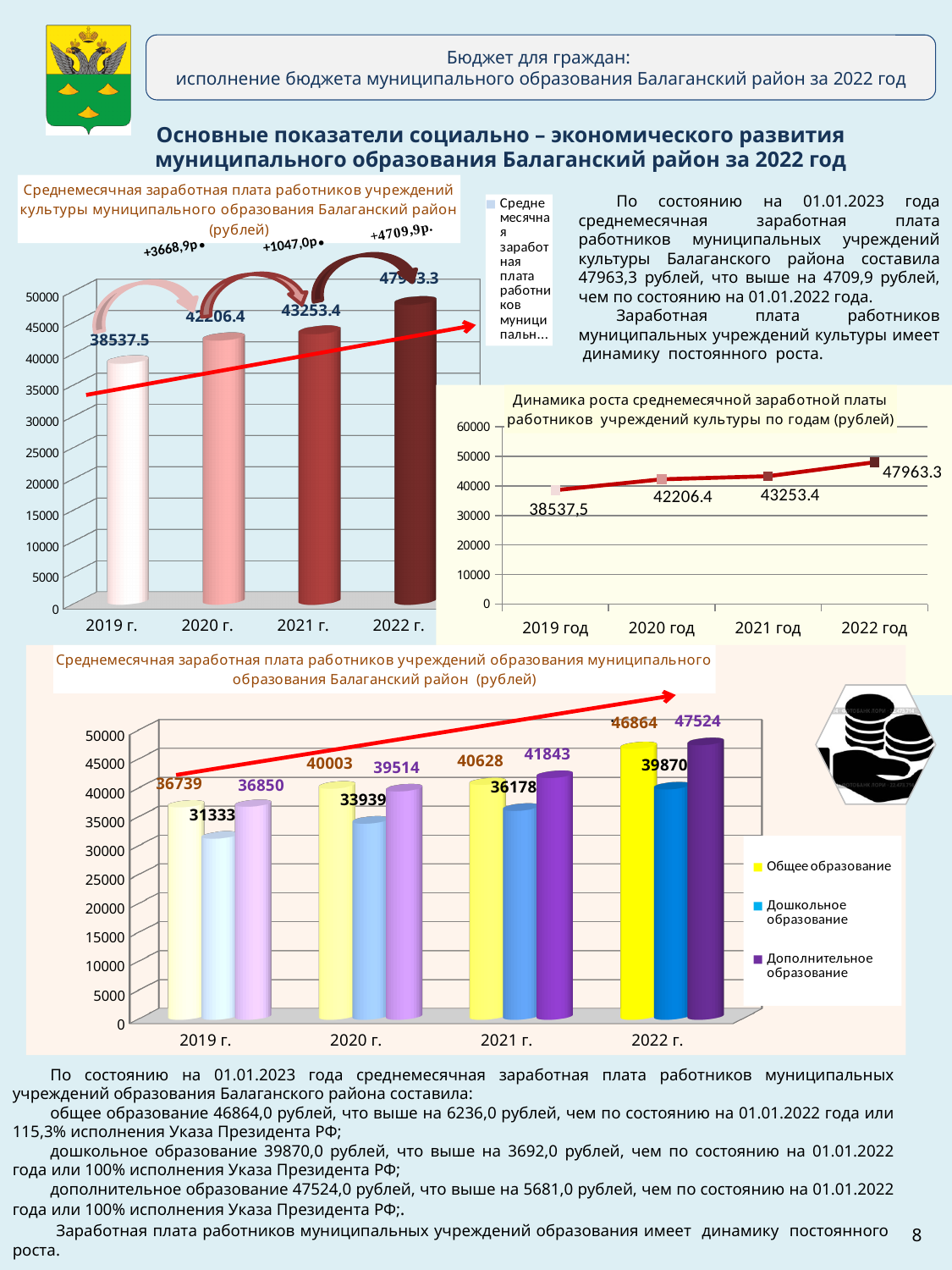
In the bottom bar chart 'Среднемесячная заработная плата работников учреждений образования', what is the difference between Дополнительное образование and Дошкольное образование in 2021 г.? 5665 In the top-left bar chart 'Среднемесячная заработная плата работников учреждений культуры', what is the value for 2020 г.? 42206.4 In the line chart 'Динамика роста среднемесячной заработной платы работников учреждений культуры по годам (рублей)', what is the value for 2019 год? 38537,5 In the bottom bar chart 'Среднемесячная заработная плата работников учреждений образования', what is the value for Общее образование in 2020 г.? 40003 What kind of chart is the chart titled 'Динамика роста среднемесячной заработной платы работников учреждений культуры по годам (рублей)'? line chart In the bottom bar chart 'Среднемесячная заработная плата работников учреждений образования', which series has the highest value in 2022 г.? Дополнительное образование In the top-left bar chart 'Среднемесячная заработная плата работников учреждений культуры', how many years are shown on the x axis? 4 In the bottom bar chart 'Среднемесячная заработная плата работников учреждений образования', what is the value for Дошкольное образование in 2022 г.? 39870 In the line chart 'Динамика роста среднемесячной заработной платы работников учреждений культуры по годам (рублей)', do the values rise or fall from 2019 год to 2022 год? rise In the top-left bar chart 'Среднемесячная заработная плата работников учреждений культуры', which year has the lowest value? 2019 г. In the bottom bar chart 'Среднемесячная заработная плата работников учреждений образования', how many series does the legend list? 3 In the line chart 'Динамика роста среднемесячной заработной платы работников учреждений культуры по годам (рублей)', what is the value for 2022 год? 47963.3